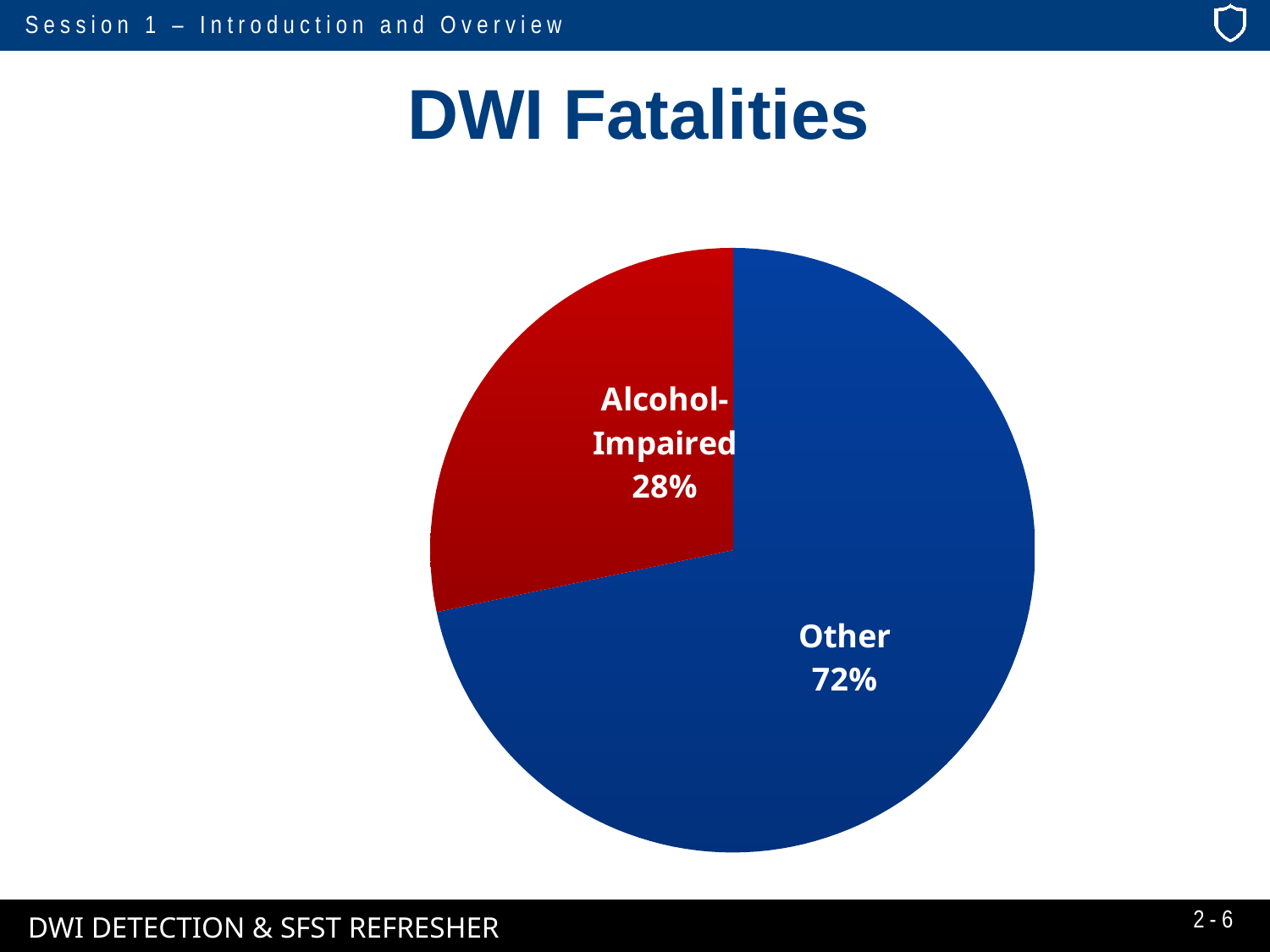
Which slice of the pie is the largest? Other What share of DWI fatalities is labelled Other? 72% What type of chart is shown on the slide? pie chart What is the difference in percentage points between the Other slice and the Alcohol-Impaired slice? 44 What colour is the Alcohol-Impaired slice? red What is the total of the two slice percentages shown? 100% What share of DWI fatalities is labelled Alcohol-Impaired? 28% How many slices does the pie chart have? 2 Which is larger, the Alcohol-Impaired slice or the Other slice? Other What is the title of the chart? DWI Fatalities Which slice of the pie is the smallest? Alcohol-Impaired